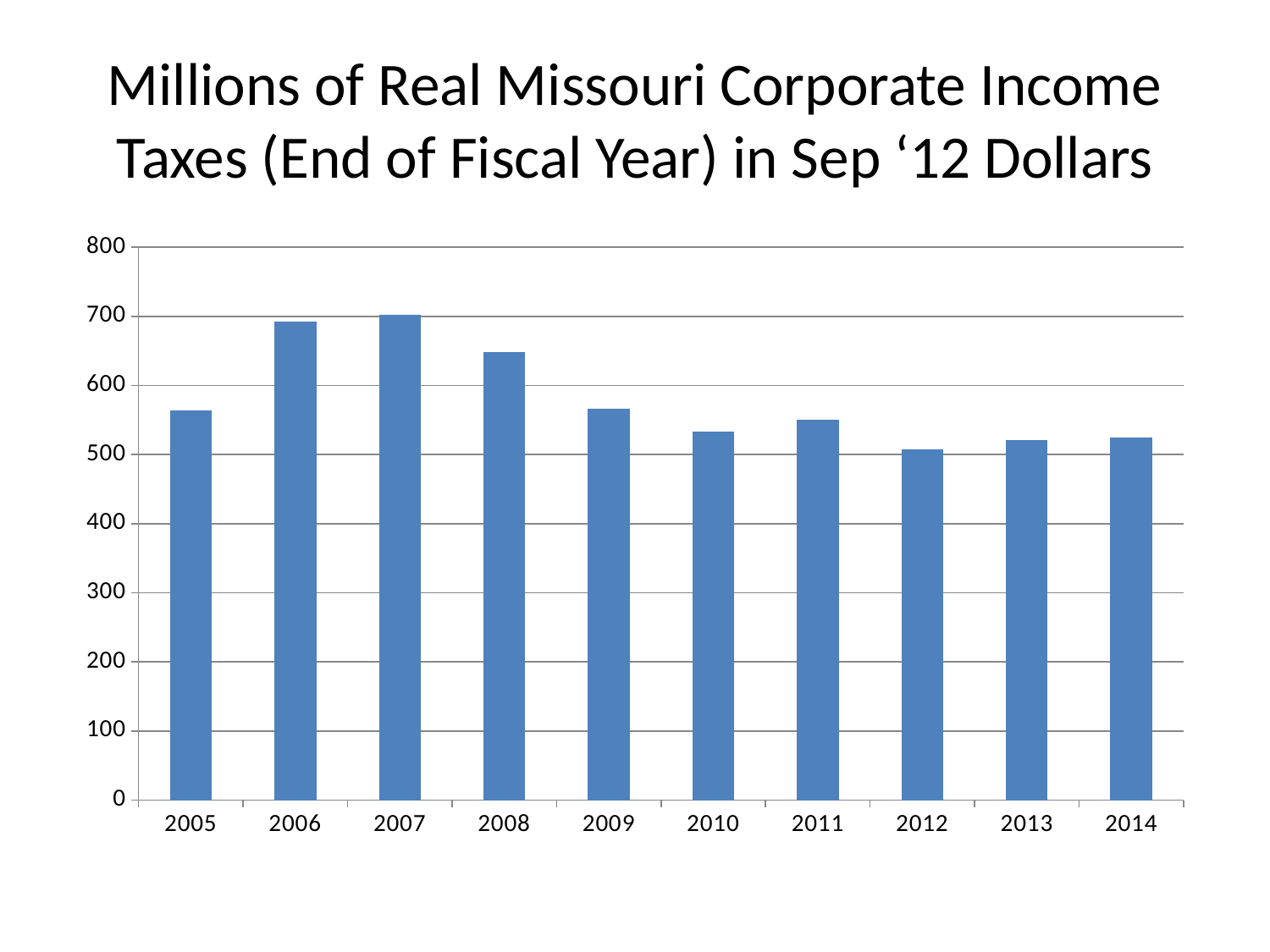
How many years are shown on the x axis of the chart? 10 Which year has the larger value, 2005 or 2006? 2006 Do the values rise or fall from 2008 to 2012? fall Is the value for 2005 greater or less than 500? greater Is the value for 2014 greater or less than 500? greater What is the title of the chart? Millions of Real Missouri Corporate Income Taxes (End of Fiscal Year) in Sep '12 Dollars Is the value for 2009 greater or less than 600? less Which year has the larger value, 2008 or 2009? 2008 What kind of chart is shown on the slide? bar chart Which year has the larger value, 2005 or 2010? 2005